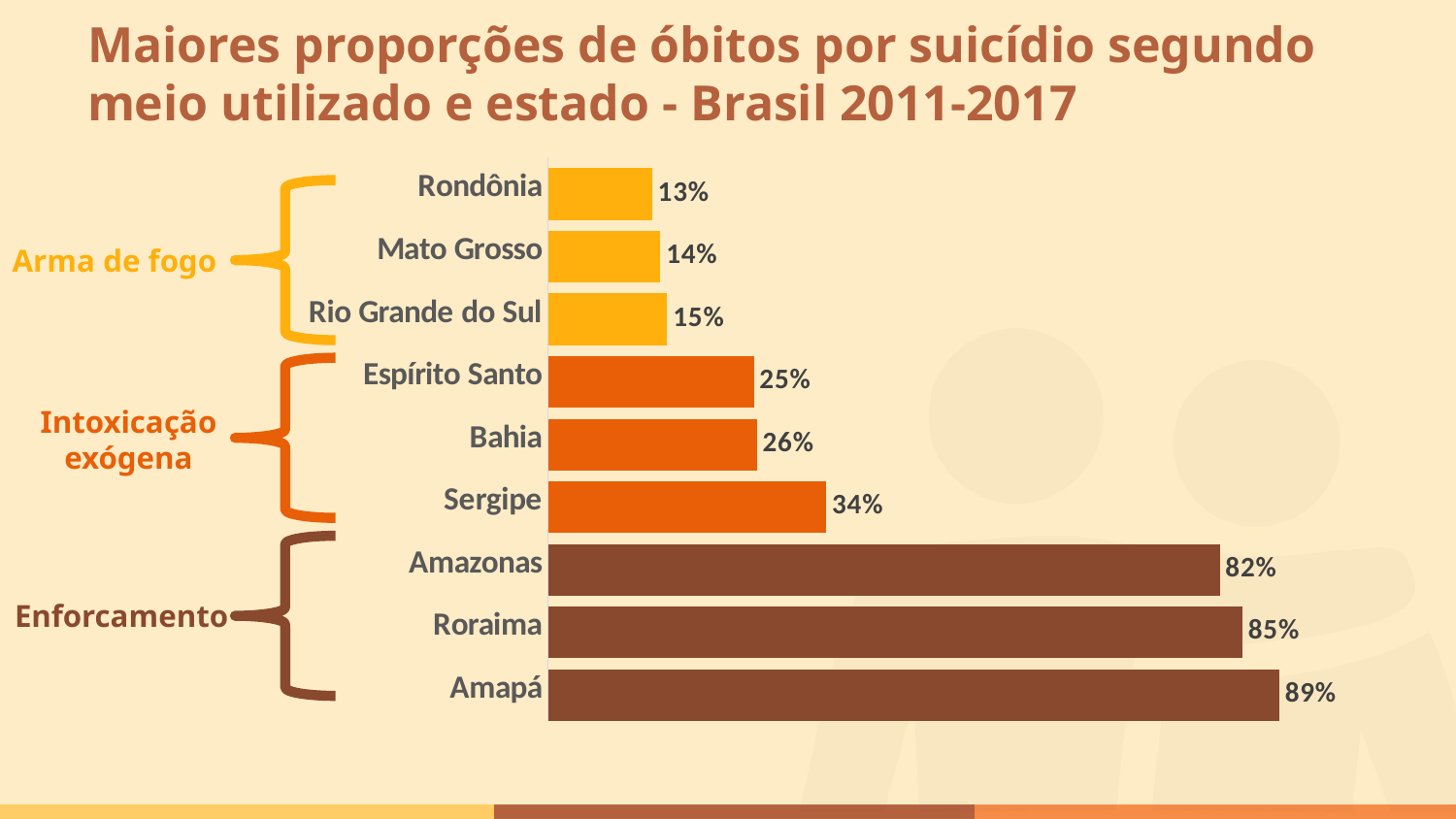
What is the difference between the values for Sergipe and Espírito Santo? 9% What is the value for Roraima? 85% How many groups (methods) are the bars divided into? 3 What is the value for Rondônia? 13% How many states are shown in the chart? 9 Which state has the highest value? Amapá What is the difference between the values for Amapá and Amazonas? 7% Which group of states is labelled 'Enforcamento'? Amazonas, Roraima, Amapá What is the value for Sergipe? 34% Which is larger, the value for Bahia or the value for Mato Grosso? Bahia What kind of chart is this? Bar chart Which state has the lowest value? Rondônia